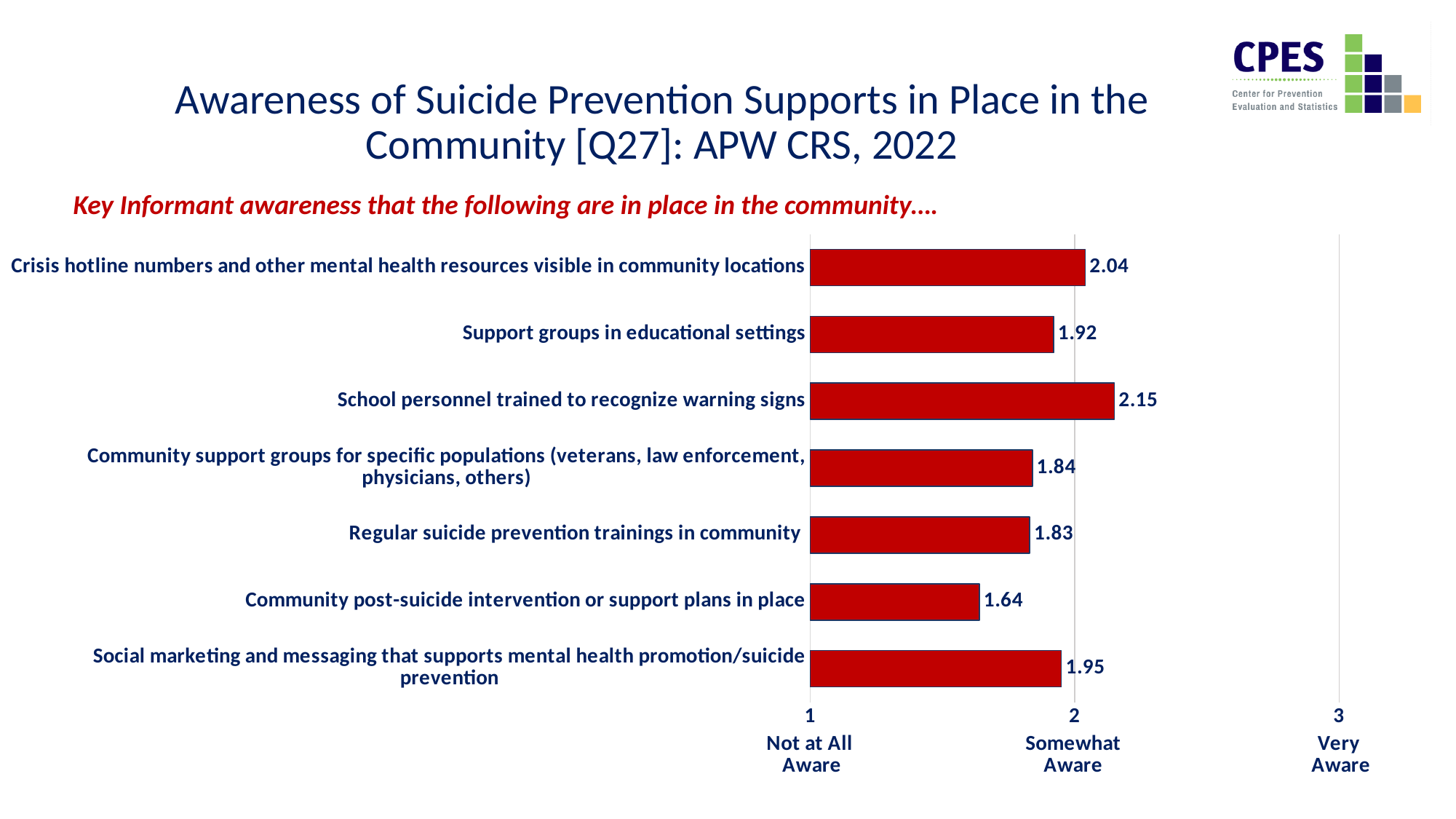
What is the difference between the values for 'Crisis hotline numbers and other mental health resources visible in community locations' and 'Support groups in educational settings'? 0.12 Which category has the highest value? School personnel trained to recognize warning signs Which is larger: the value for 'Crisis hotline numbers and other mental health resources visible in community locations' or the value for 'Social marketing and messaging that supports mental health promotion/suicide prevention'? Crisis hotline numbers and other mental health resources visible in community locations Which category has the lowest value? Community post-suicide intervention or support plans in place What kind of chart is shown on the slide? Bar chart What is the value for 'School personnel trained to recognize warning signs'? 2.15 How many categories are shown in the chart? 7 Is the value for 'Regular suicide prevention trainings in community' greater or less than 2? less What label does the x axis show at the value 3? Very Aware What is the value for 'Community post-suicide intervention or support plans in place'? 1.64 What is the difference between the values for 'School personnel trained to recognize warning signs' and 'Community post-suicide intervention or support plans in place'? 0.51 What is the value for 'Support groups in educational settings'? 1.92